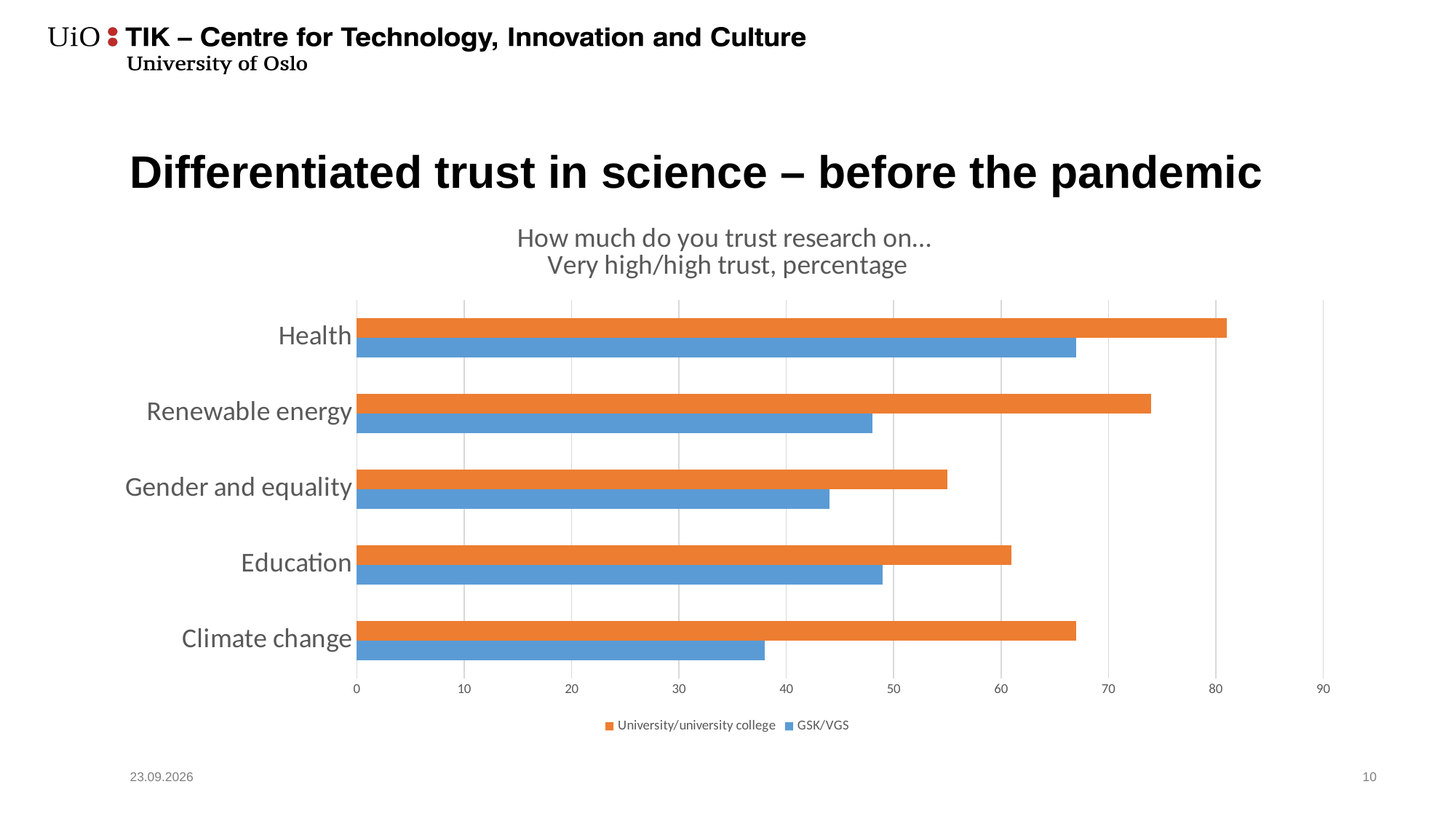
Which category has the lowest value for GSK/VGS? Climate change Which category has the highest value for University/university college? Health Is the University/university college value for Renewable energy greater or less than 70? greater Which category has the highest value for GSK/VGS? Health Which category has the lowest value for University/university college? Gender and equality How many series does the legend list? 2 Which is larger for University/university college: Climate change or Education? Climate change Is the GSK/VGS value for Climate change greater or less than 50? less How many categories are shown on the chart? 5 Is the University/university college value for Health greater or less than 70? greater What is the title of the chart? How much do you trust research on… Very high/high trust, percentage What kind of chart is shown on the slide? Bar chart